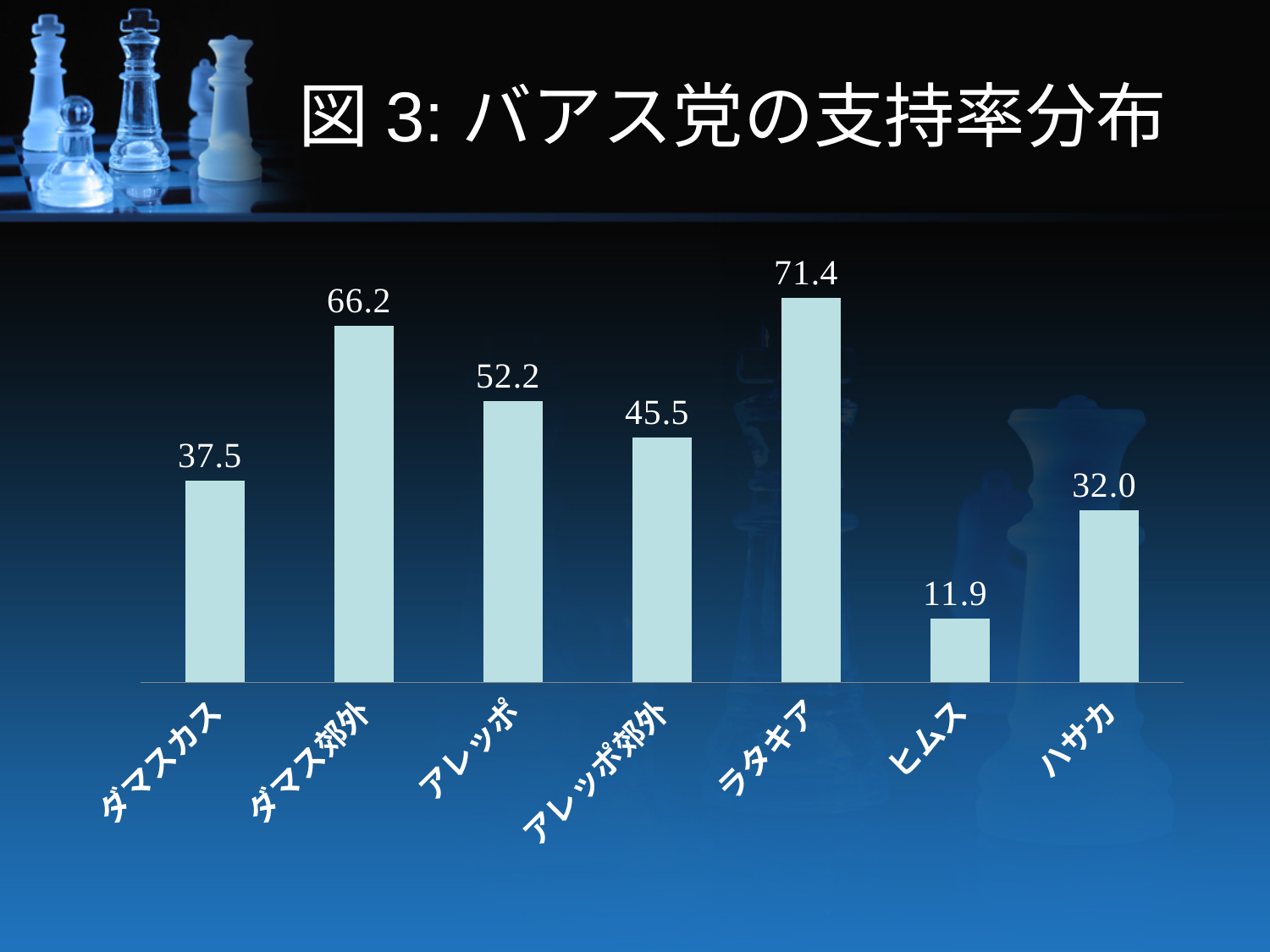
How many categories are shown in the chart? 7 Which is larger, the value for アレッポ or the value for アレッポ郊外? アレッポ What is the value for ヒムス? 11.9 What is the difference between the values for ラタキア and ヒムス? 59.5 What kind of chart is shown on the slide? bar chart What is the value for ハサカ? 32.0 What is the title of the slide? 図 3: バアス党の支持率分布 What is the difference between the values for ダマス郊外 and ダマスカス? 28.7 Which category has the lowest value? ヒムス What is the value for ラタキア? 71.4 Which category has the highest value? ラタキア What is the value for ダマスカス? 37.5